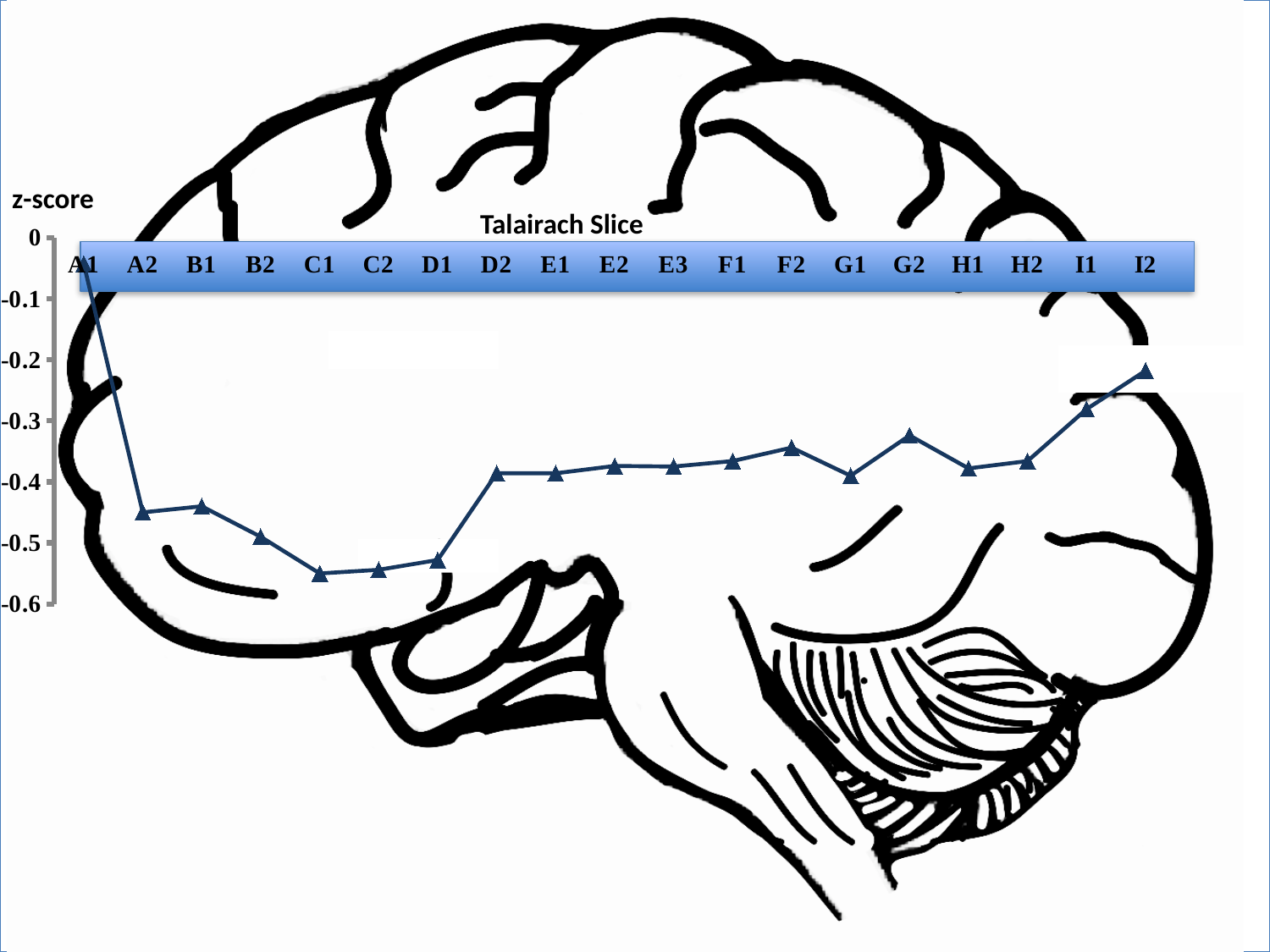
Is the z-score for C1 greater or less than -0.5? less What kind of chart is shown on the slide? line chart Is the z-score for I2 greater or less than -0.3? greater Which Talairach slice has the highest z-score? A1 Which has the larger z-score, D1 or D2? D2 Is the z-score for F2 greater or less than -0.4? greater What is the title of the x axis? Talairach Slice How many Talairach slice categories are plotted along the x axis? 19 Which has the larger z-score, I1 or I2? I2 Do the z-scores rise or fall from A1 to C1? fall